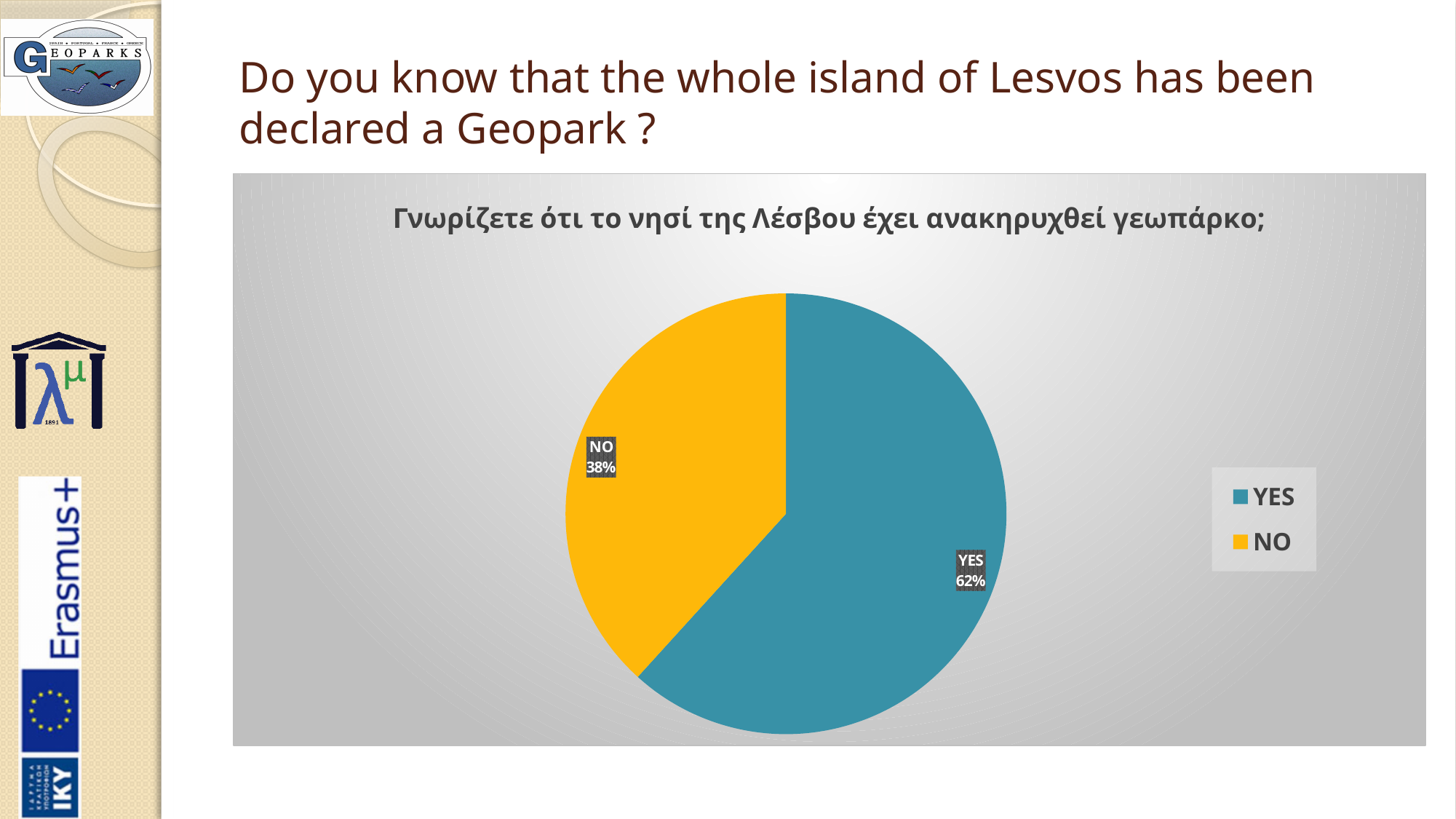
Which answer has the smallest share of the pie? NO What colour is the YES slice? teal What percentage of respondents answered YES? 62% What percentage of respondents answered NO? 38% Which answer has the largest share of the pie? YES Which slice is larger, YES or NO? YES What share of the pie does the YES slice represent? 62% What colour is the NO slice? yellow What is the difference in percentage points between the YES and NO slices? 24 What kind of chart is shown on the slide? pie chart How many entries does the legend list? 2 How many slices does the pie chart have? 2